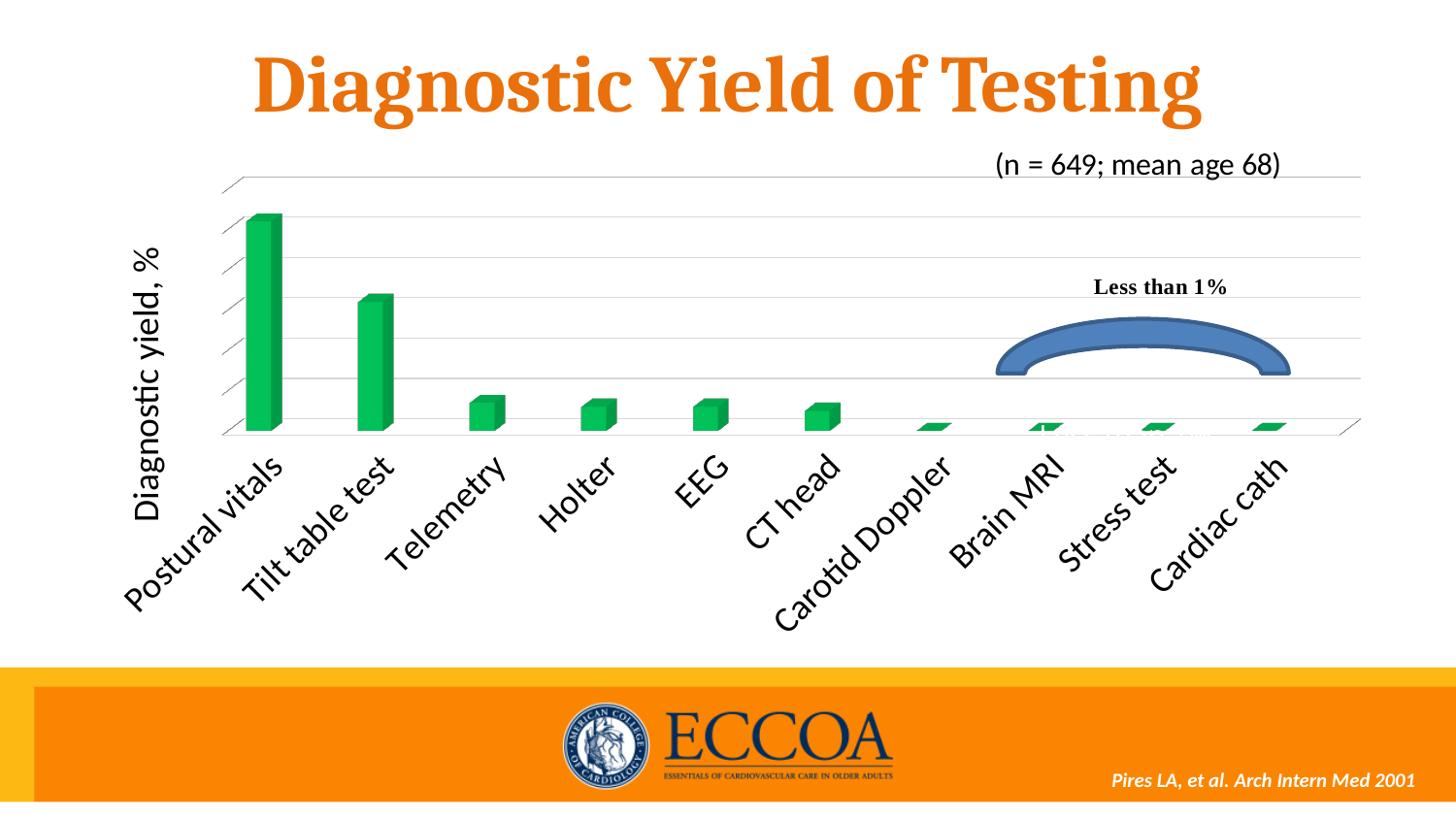
Which test has the highest diagnostic yield in the chart? Postural vitals Do the diagnostic yield values rise or fall moving from left to right along the x axis? fall Which has the larger diagnostic yield, Holter or Cardiac cath? Holter Which has the larger diagnostic yield, CT head or Postural vitals? Postural vitals Which has the larger diagnostic yield, Postural vitals or Tilt table test? Postural vitals According to the annotation on the chart, what is the diagnostic yield of Brain MRI, Stress test and Cardiac cath? Less than 1% What is the title of the chart on the slide? Diagnostic Yield of Testing What kind of chart is shown on the slide? bar chart What is the label on the y axis of the chart? Diagnostic yield, % How many tests (categories) are shown on the x axis of the chart? 10 What sample size (n) is stated on the chart? 649